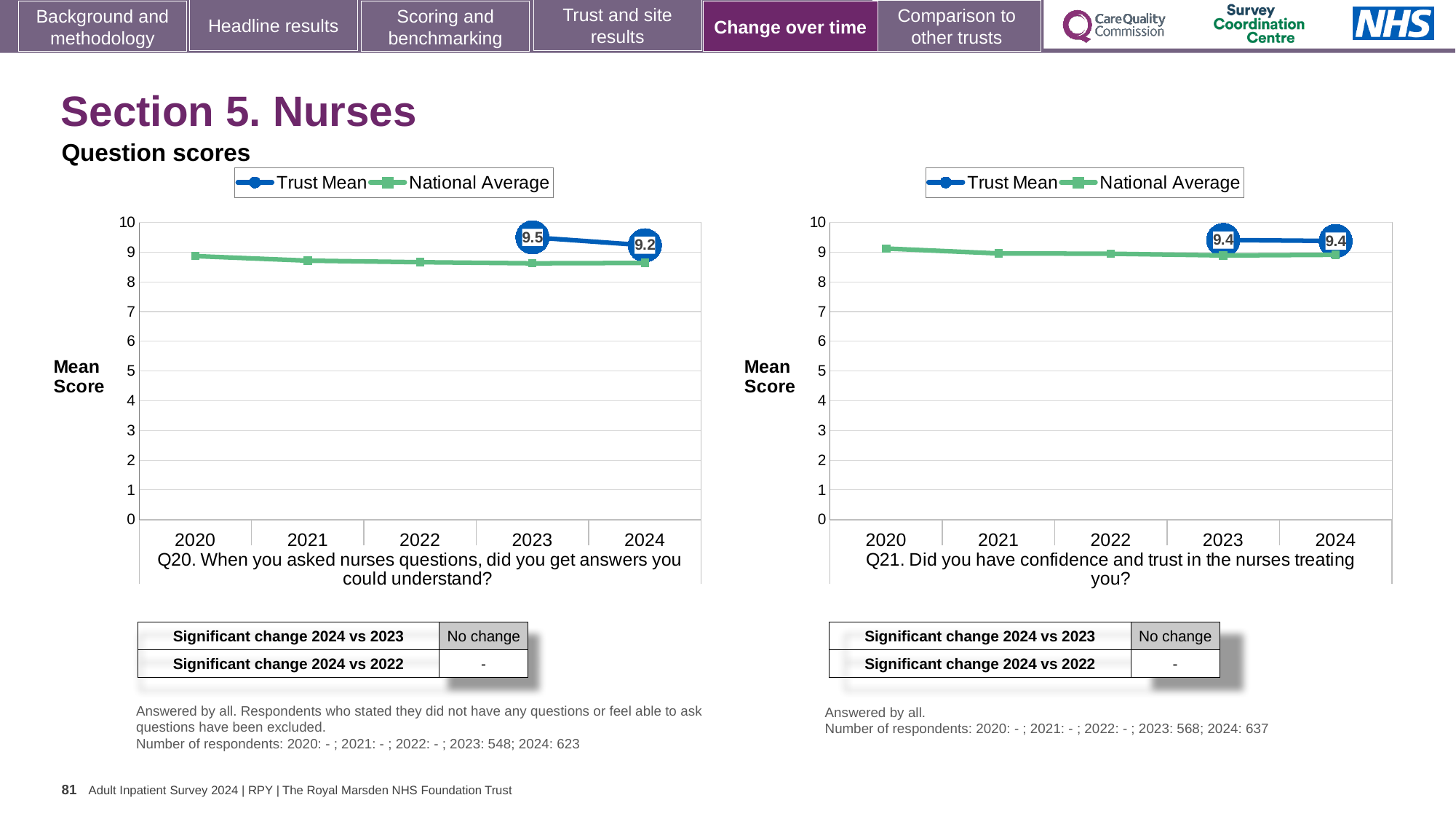
In the Q20 chart on the left, what is the difference between the Trust Mean scores for 2023 and 2024? 0.3 What type of chart is the Q21 chart on the right? line chart In the Q20 chart on the left, is the National Average for 2020 greater or less than 8? greater In the Q20 chart on the left, which is larger, the Trust Mean for 2023 or the Trust Mean for 2024? 2023 In the Q20 chart on the left, what is the Trust Mean score for 2024? 9.2 In the Q20 chart on the left, does the Trust Mean rise or fall from 2023 to 2024? fall In the Q21 chart on the right, what is the Trust Mean score for 2024? 9.4 In the Q20 chart on the left, what is the Trust Mean score for 2023? 9.5 How many years are shown on the x axis of the Q21 chart on the right? 5 In the Q21 chart on the right, is the National Average for 2024 greater or less than 8? greater In the Q21 chart on the right, what is the Trust Mean score for 2023? 9.4 How many series does the legend of the Q20 chart on the left list? 2